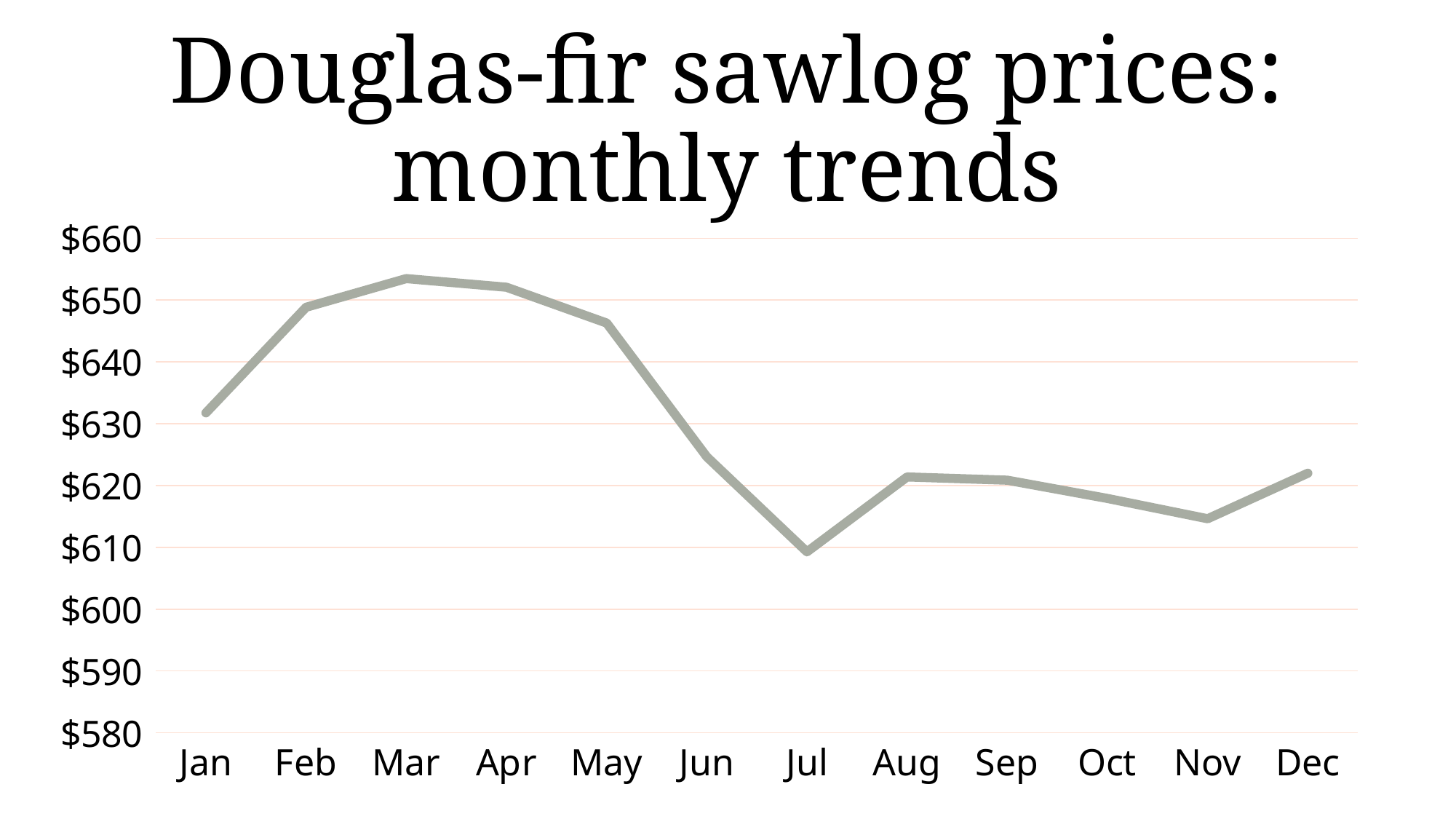
Which month has the higher price, Feb or Jun? Feb Which month has the lowest Douglas-fir sawlog price? Jul What is the title of the chart? Douglas-fir sawlog prices: monthly trends What kind of chart is shown on the slide? line chart Which month has the highest Douglas-fir sawlog price? Mar How many months are plotted along the x axis? 12 Is the value for Jan greater or less than $640? less Is the value for Jul greater or less than $620? less Is the value for Nov greater or less than $620? less Do the prices rise or fall from Mar to Jul? fall